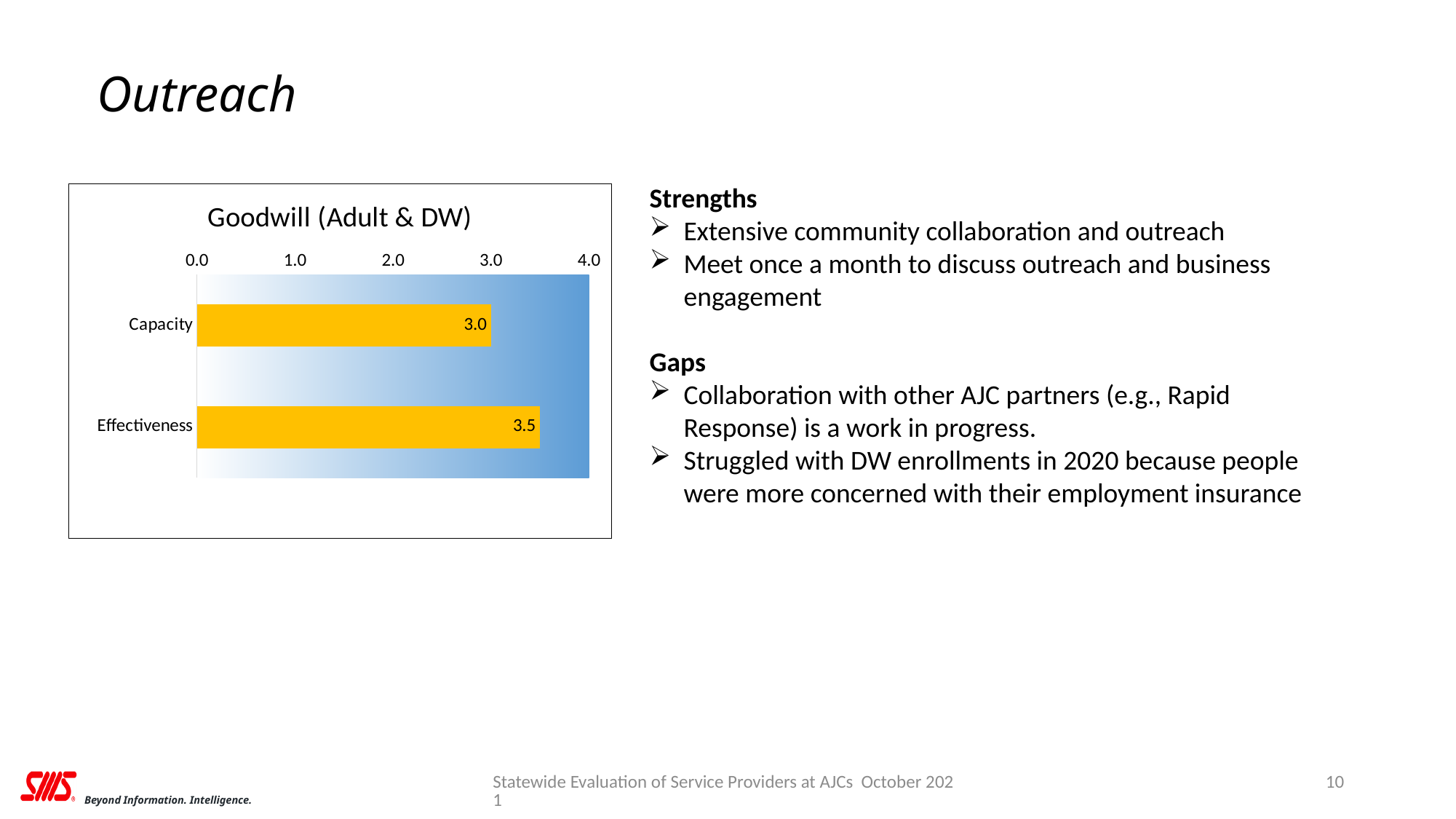
What is the difference between the Effectiveness and Capacity values? 0.5 What is the maximum value shown on the chart's axis? 4.0 Is the value for Effectiveness greater or less than 3.0? greater What kind of chart is shown on the slide? bar chart Which category has the lowest value? Capacity What is the value for Effectiveness? 3.5 Is the value for Capacity greater or less than 4.0? less What is the value for Capacity? 3.0 How many categories are shown in the chart? 2 Which category has the highest value? Effectiveness Which is larger, the value for Capacity or the value for Effectiveness? Effectiveness What is the title of the chart? Goodwill (Adult & DW)